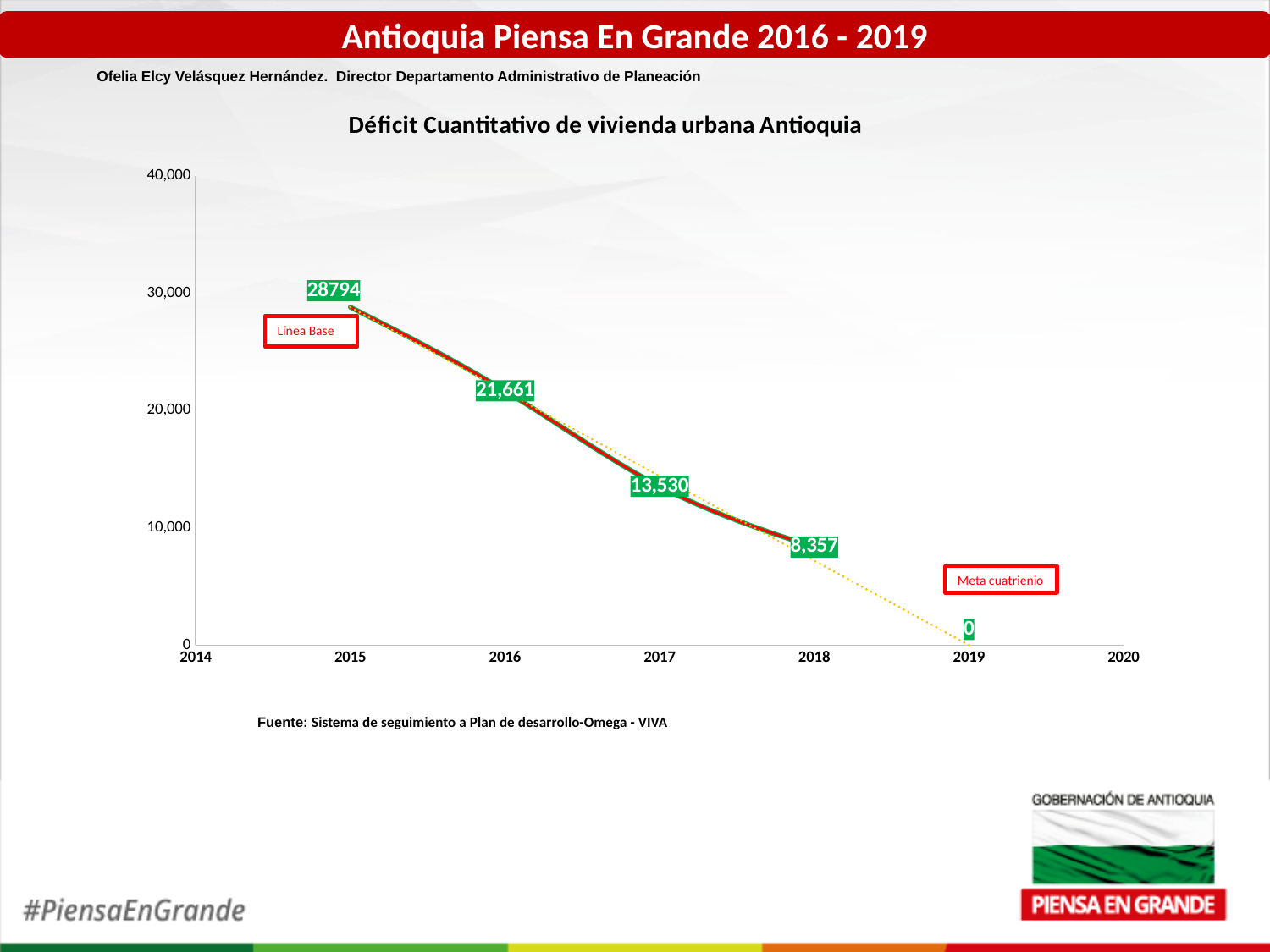
What is the value for 2018? 8,357 What is the value for 2019? 0 Which year has the highest value? 2015 Do the values rise or fall from 2015 to 2019? fall What kind of chart is shown on the slide? line chart How many data points are labelled on the line? 5 What is the title of the chart? Déficit Cuantitativo de vivienda urbana Antioquia What is the value for 2017? 13,530 What is the value for 2016? 21,661 What is the value for 2015? 28794 What is the difference between the values for 2015 and 2016? 7,133 Which year has the lowest value? 2019